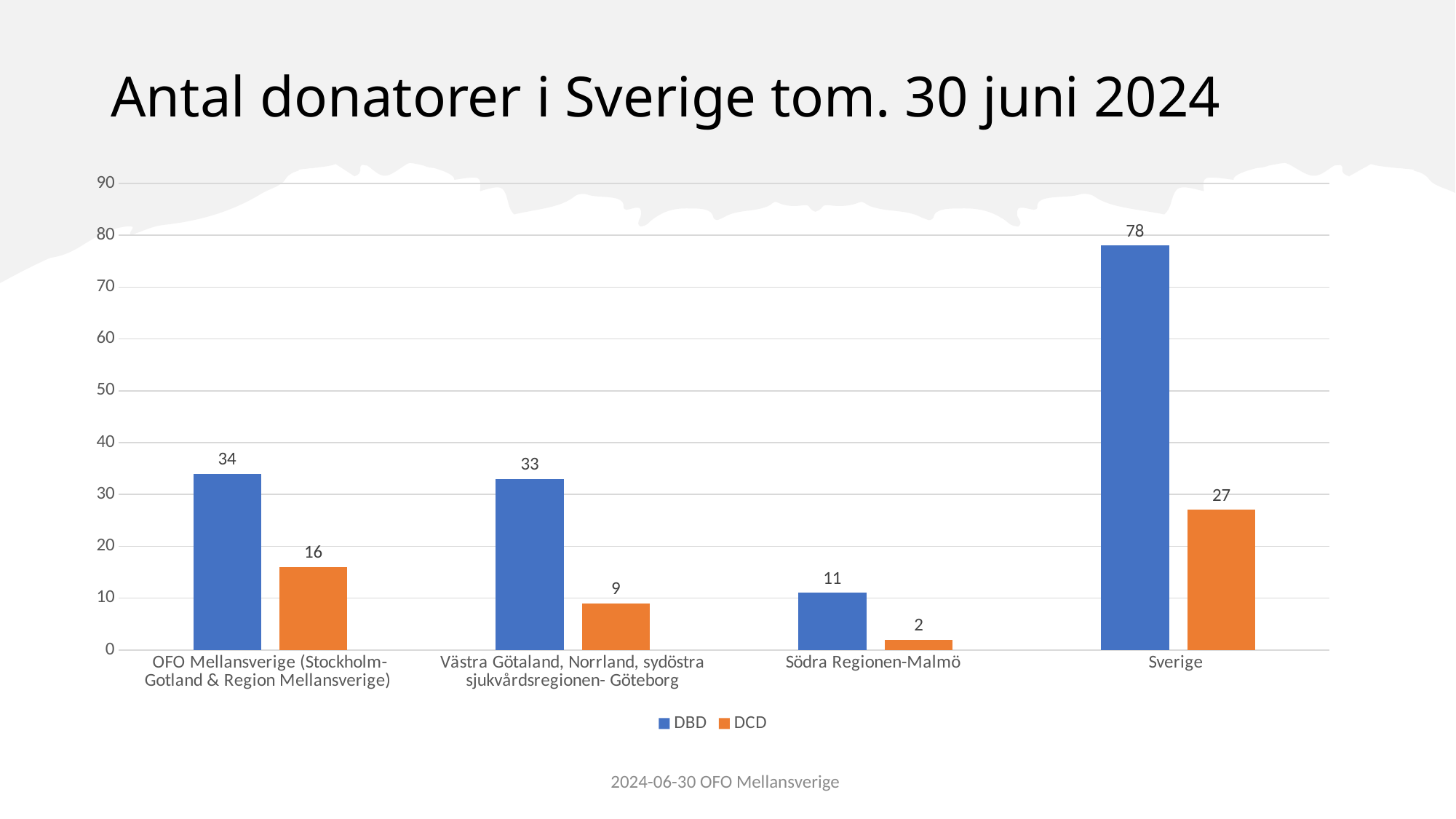
Which is larger: the DBD value for Södra Regionen-Malmö or the DCD value for OFO Mellansverige? DCD value for OFO Mellansverige What is the DCD value for OFO Mellansverige (Stockholm-Gotland & Region Mellansverige)? 16 What type of chart is shown on the slide? Bar chart What is the DBD value for Sverige? 78 How many categories are shown on the x axis? 4 What is the difference between the DBD and DCD values for Sverige? 51 What is the difference between the DCD values for OFO Mellansverige and Västra Götaland, Norrland, sydöstra sjukvårdsregionen- Göteborg? 7 What is the DCD value for Södra Regionen-Malmö? 2 Which category has the lowest DCD value? Södra Regionen-Malmö Which category has the highest DBD value? Sverige How many series does the legend list? 2 What is the DBD value for Västra Götaland, Norrland, sydöstra sjukvårdsregionen- Göteborg? 33